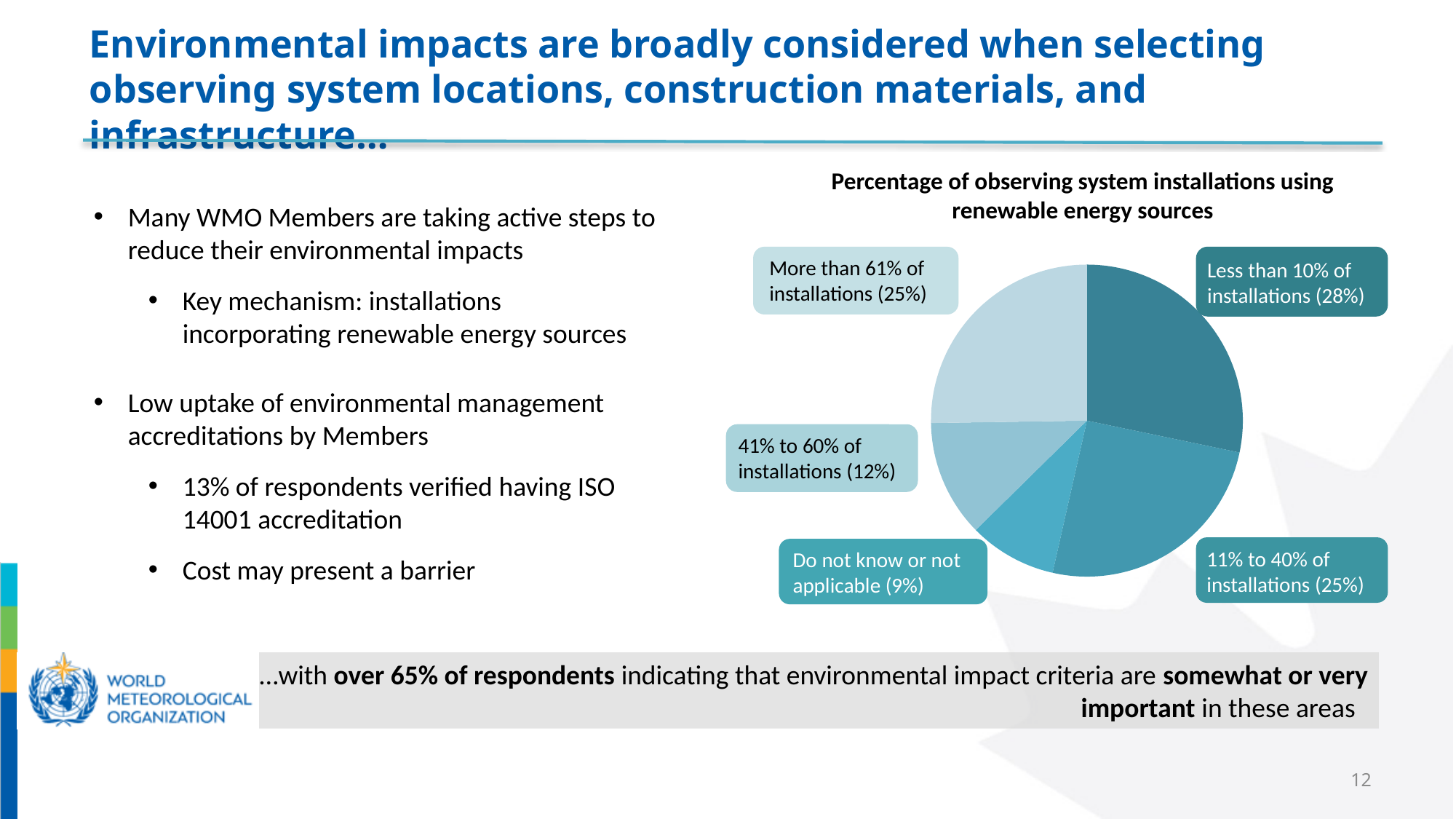
What is the difference in percentage points between 'Less than 10% of installations' and 'Do not know or not applicable'? 19 percentage points How many slices does the pie chart have? 5 What is the title of the chart? Percentage of observing system installations using renewable energy sources What share of the pie is 'More than 61% of installations'? 25% What share of the pie is '41% to 60% of installations'? 12% Which category has the smallest slice of the pie? Do not know or not applicable What share of the pie is '11% to 40% of installations'? 25% Which is larger: the share for '41% to 60% of installations' or for 'Do not know or not applicable'? 41% to 60% of installations Which category has the largest slice of the pie? Less than 10% of installations What type of chart is shown on the slide? Pie chart